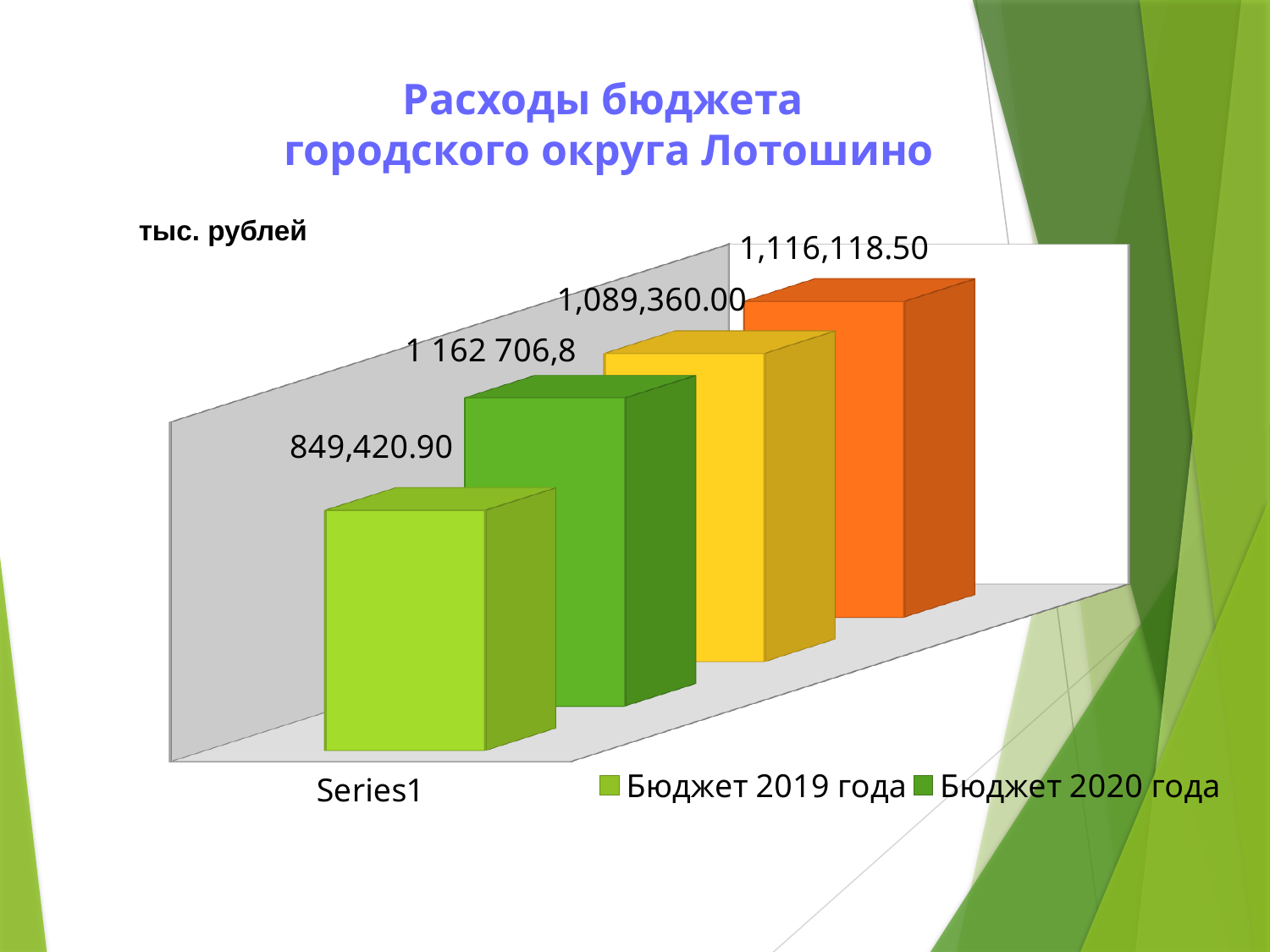
What is the title of the chart on the slide? Расходы бюджета городского округа Лотошино Which bar has the lowest value on the chart? Бюджет 2019 года What kind of chart is shown on the slide? bar chart Which is larger, the value for Бюджет 2019 года or Бюджет 2020 года? Бюджет 2020 года What is the value shown for Бюджет 2020 года? 1 162 706,8 What unit is indicated for the values on the chart? тыс. рублей What is the value printed above the orange bar? 1,116,118.50 How many bars are plotted on the chart? 4 What is the value printed above the yellow bar? 1,089,360.00 What is the value shown for Бюджет 2019 года? 849,420.90 Which bar has the highest value on the chart? Бюджет 2020 года